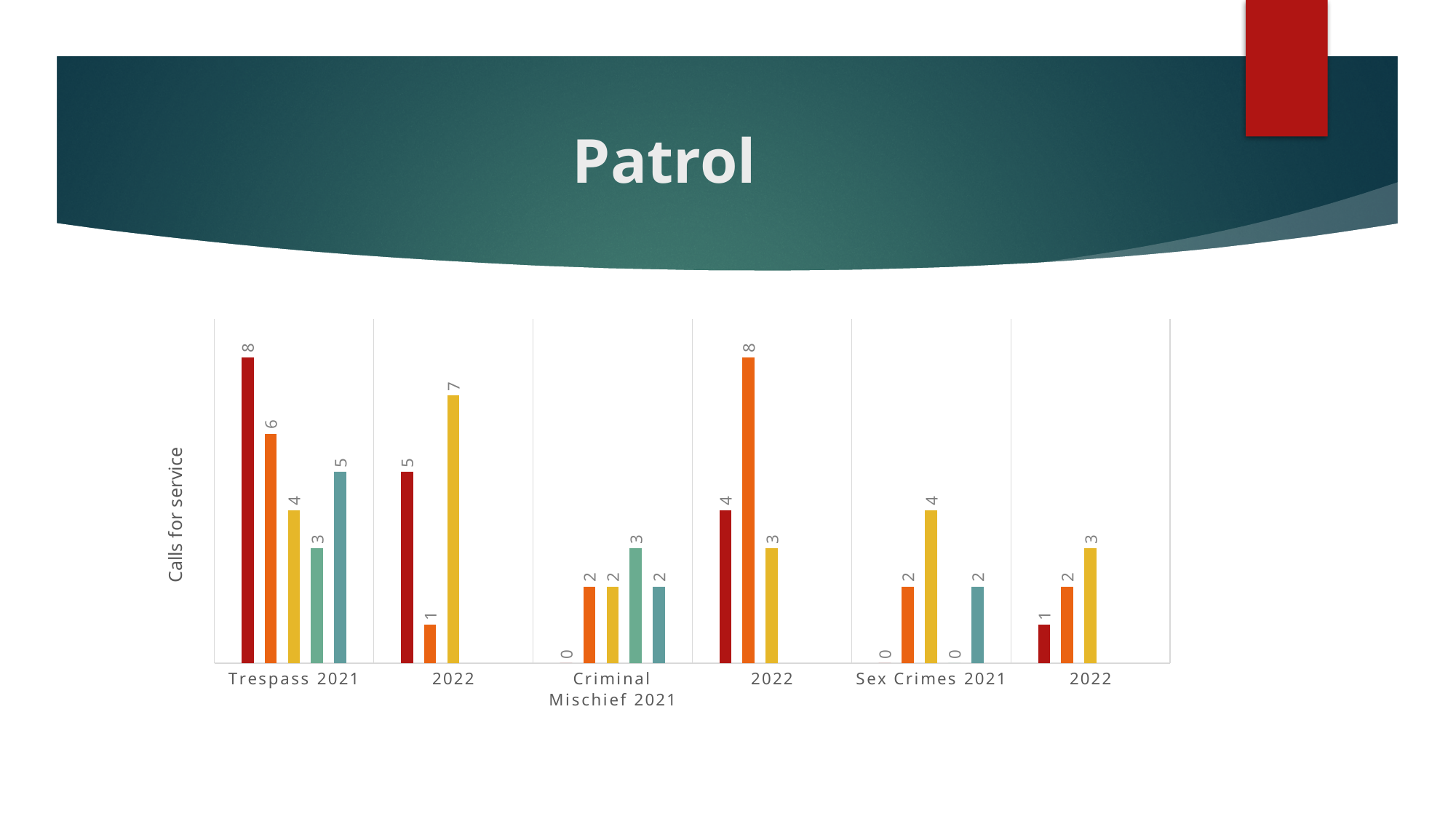
What is the value of the dark red bar for Criminal Mischief 2021? 0 How many categories are shown along the x axis of the chart? 6 Which bar is the lowest in the 2022 category next to Trespass 2021? the orange bar (1) What is the value of the orange bar for the 2022 category next to Criminal Mischief 2021? 8 What is the difference between the dark red bar and the orange bar for Trespass 2021? 2 What is the label of the vertical axis? Calls for service What is the value of the dark red bar for Trespass 2021? 8 What is the total of all the bars in the Trespass 2021 category? 26 What is the value of the yellow bar for the 2022 category next to Trespass 2021? 7 What kind of chart is shown on the slide? bar chart Which is larger for the 2022 category next to Sex Crimes 2021: the dark red bar or the yellow bar? the yellow bar Which bar is the highest in the Sex Crimes 2021 category? the yellow bar (4)